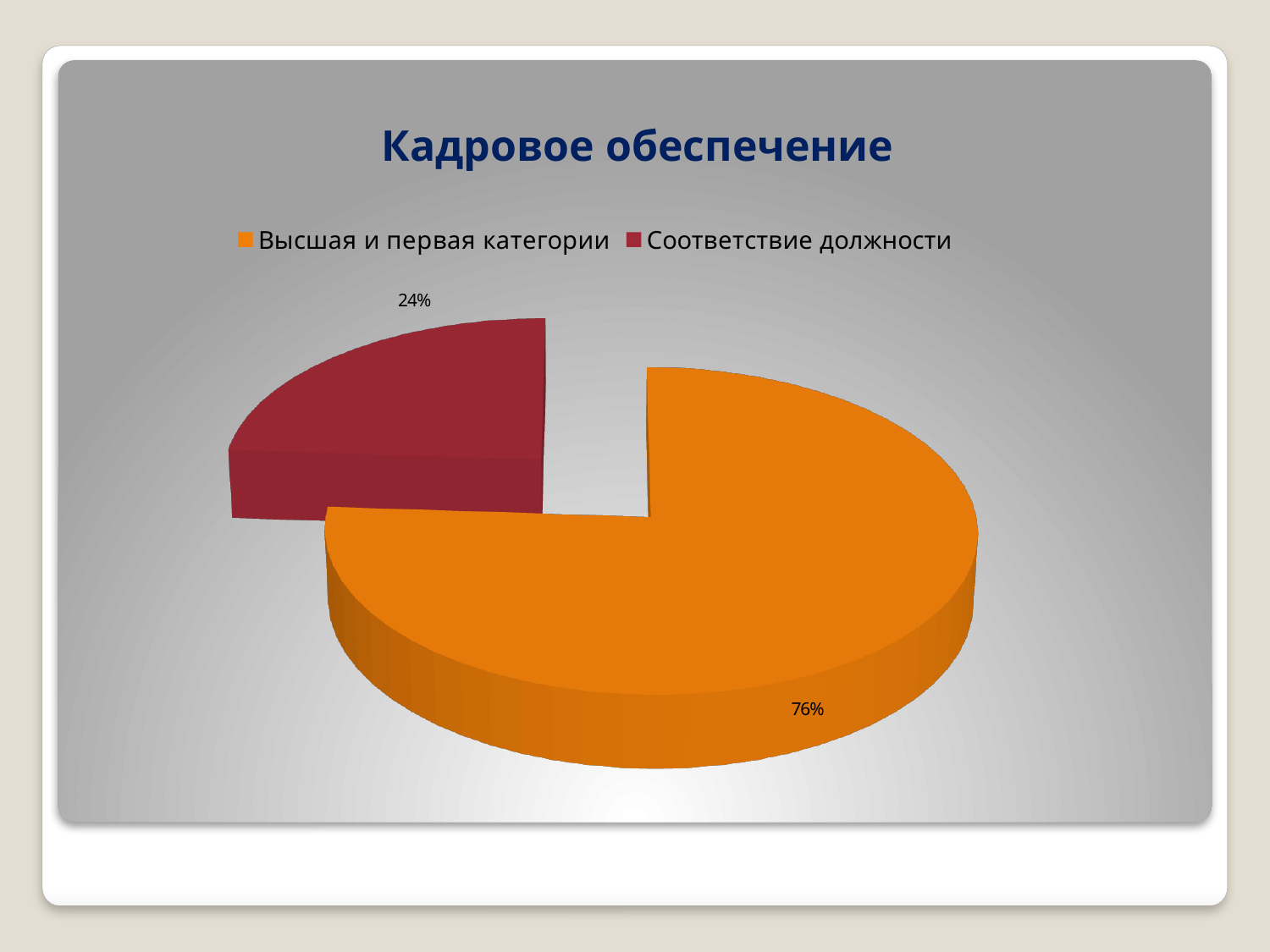
What colour is the slice for "Соответствие должности"? Dark red Which category has the smallest slice of the pie? Соответствие должности How many entries does the legend list? 2 What share of the pie does "Высшая и первая категории" represent? 76% What kind of chart is shown on the slide? Pie chart What is the difference in percentage points between the "Высшая и первая категории" slice and the "Соответствие должности" slice? 52 Which category has the largest slice of the pie? Высшая и первая категории Which is larger: the slice for "Высшая и первая категории" or the slice for "Соответствие должности"? Высшая и первая категории How many slices does the pie chart have? 2 What is the title of the chart? Кадровое обеспечение What share of the pie does "Соответствие должности" represent? 24%